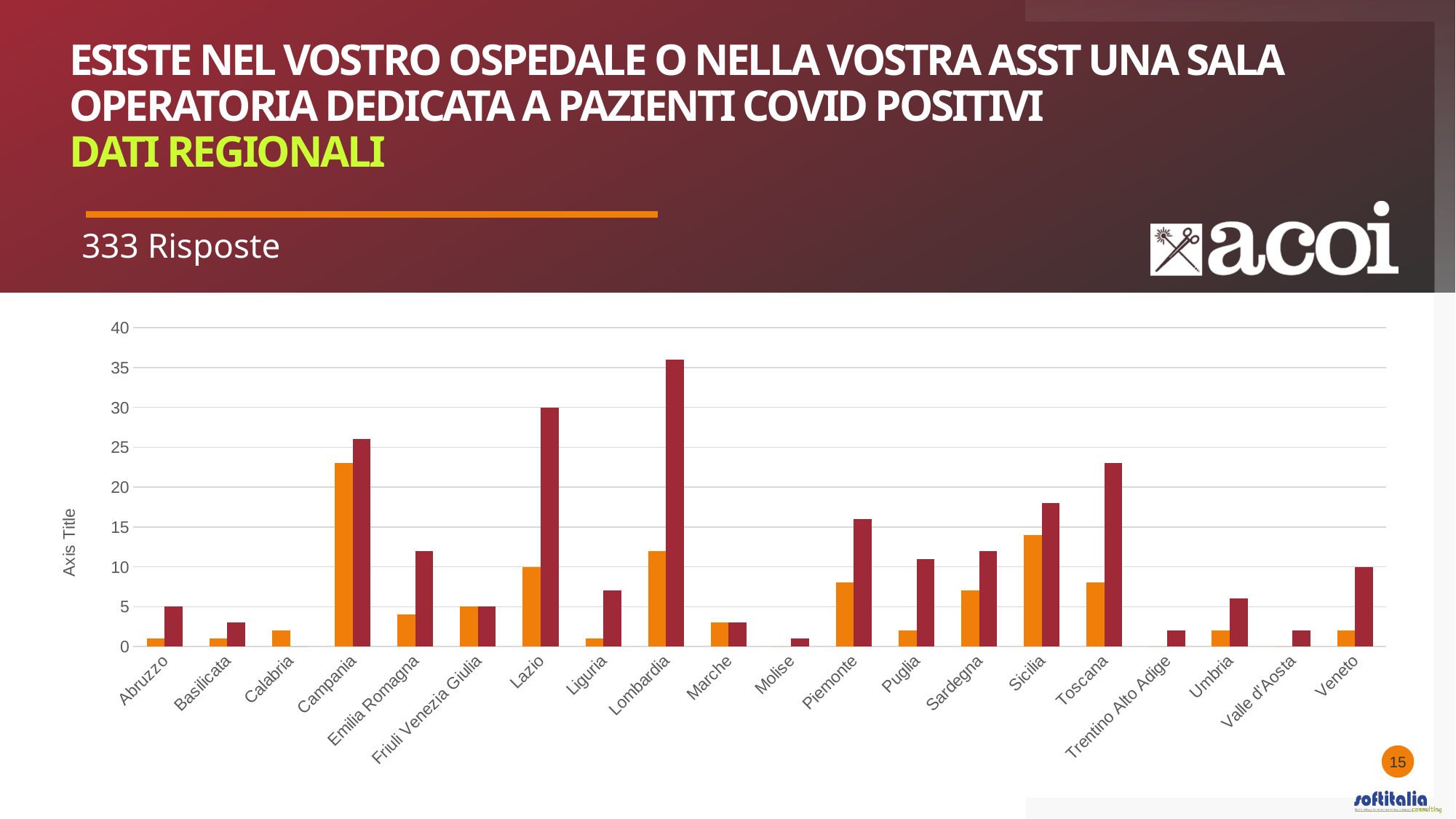
Is the orange bar for Campania greater or less than 20? greater Is the dark red bar for Lombardia greater or less than 30? greater What is the label shown on the vertical axis of the chart? Axis Title Which region has the tallest dark red bar? Lombardia Which is larger, the dark red bar for Lazio or the dark red bar for Toscana? Lazio What is the value of the orange bar for Lazio? 10 How many regions are listed along the x axis of the chart? 20 What kind of chart is shown on the slide? bar chart What is the value of the dark red bar for Lazio? 30 Is the dark red bar for Toscana greater or less than 20? greater Which region has the tallest orange bar? Campania What is the value of the dark red bar for Veneto? 10